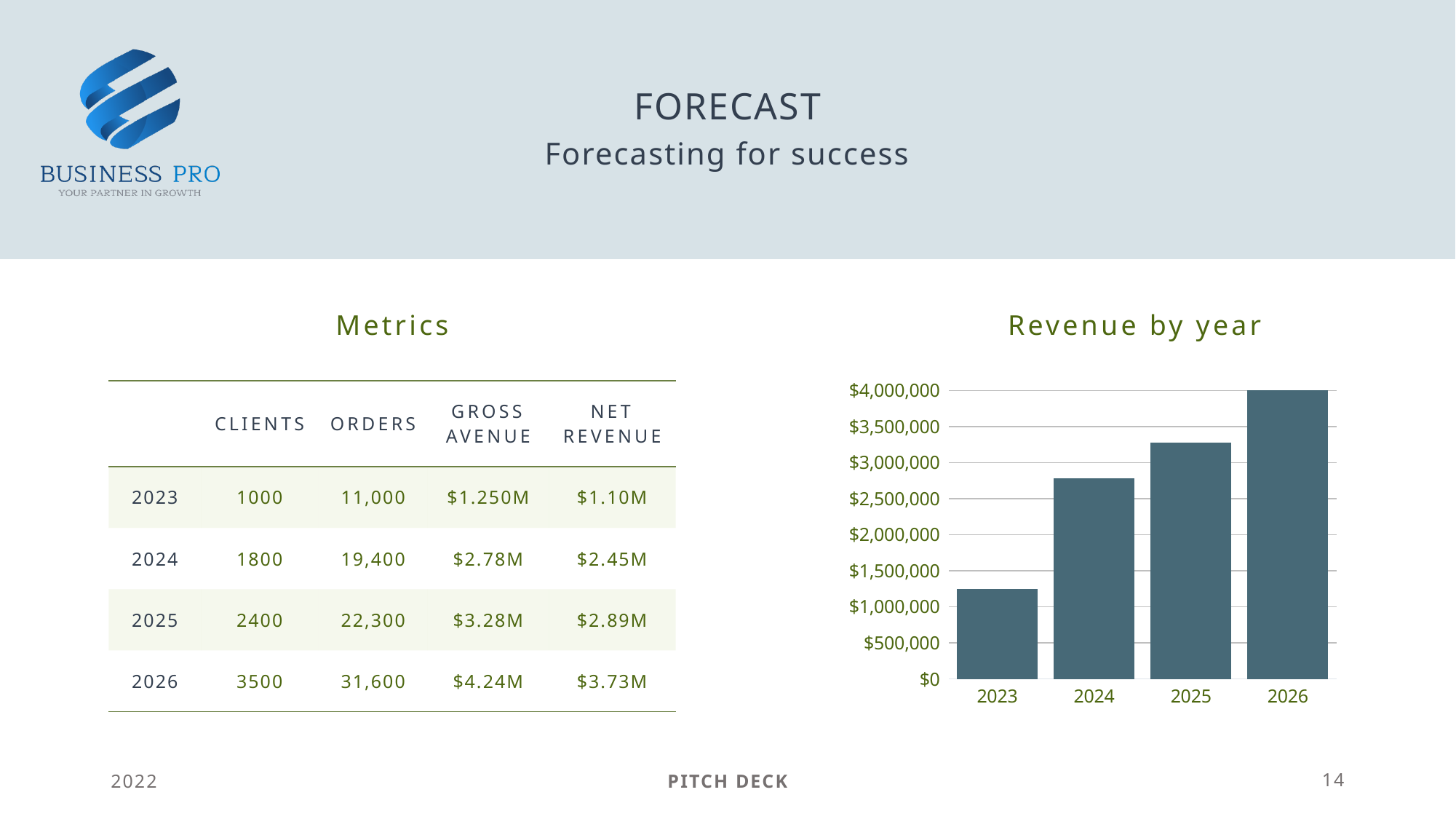
In the "Revenue by year" chart, is the value for 2026 greater or less than $3,500,000? greater In the "Revenue by year" chart, which year has the lowest revenue? 2023 In the "Revenue by year" chart, which year has the highest revenue? 2026 In the "Revenue by year" chart, is the value for 2023 greater or less than $1,500,000? less In the "Revenue by year" chart, is the value for 2023 greater or less than $1,000,000? greater What kind of chart is the "Revenue by year" chart? bar chart In the "Revenue by year" chart, does revenue rise or fall from 2023 to 2026? rise In the "Revenue by year" chart, is revenue higher in 2024 or in 2025? 2025 How many years are shown on the x axis of the "Revenue by year" chart? 4 What is the title of the bar chart on the right of the slide? Revenue by year